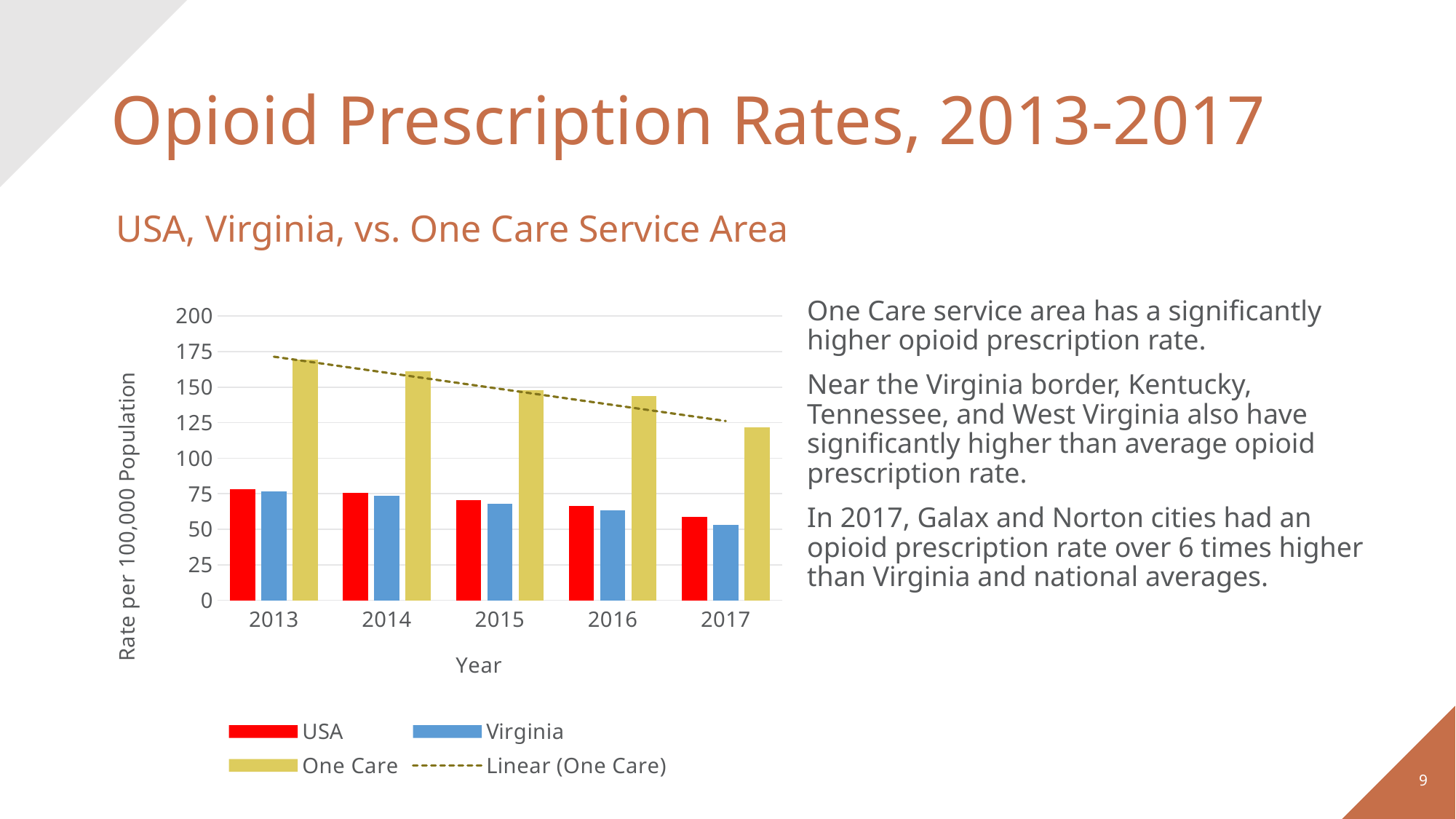
Is the One Care value for 2017 greater or less than 125? less What is the label on the chart's vertical axis? Rate per 100,000 Population How many years are shown on the x axis of the chart? 5 Is the USA value for 2017 greater or less than 75? less Is the Virginia value for 2013 greater or less than 50? greater Which year has the lowest Virginia value? 2017 How many entries does the chart's legend list? 4 In 2015, which is larger: the USA value or the One Care value? One Care What kind of chart is shown on the slide? bar chart Do the One Care values rise or fall from 2013 to 2017? fall Which year has the highest One Care value? 2013